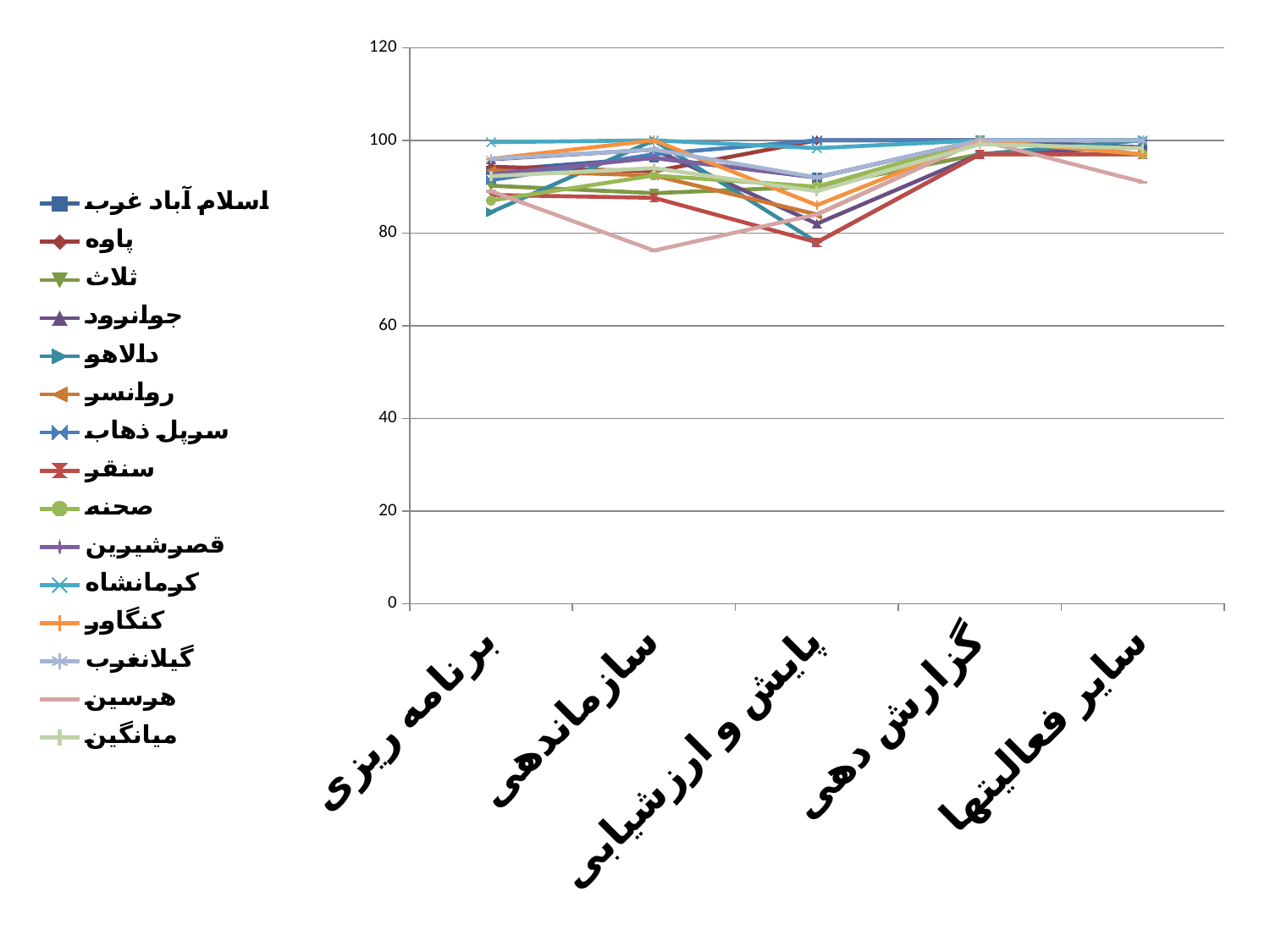
For هرسین, is the value larger at سازماندهی or at گزارش دهی? گزارش دهی Which series has the lowest value at سازماندهی? هرسین Does the line for هرسین rise or fall from گزارش دهی to سایر فعالیتها? fall What kind of chart is shown on the slide? line chart Is the value for هرسین at سازماندهی greater or less than 80? less Is the value for هرسین at سایر فعالیتها greater or less than 80? greater How many series does the legend list? 15 Which category is the last one on the x axis? سایر فعالیتها How many categories are shown along the x axis? 5 What is the highest value shown on the y axis? 120